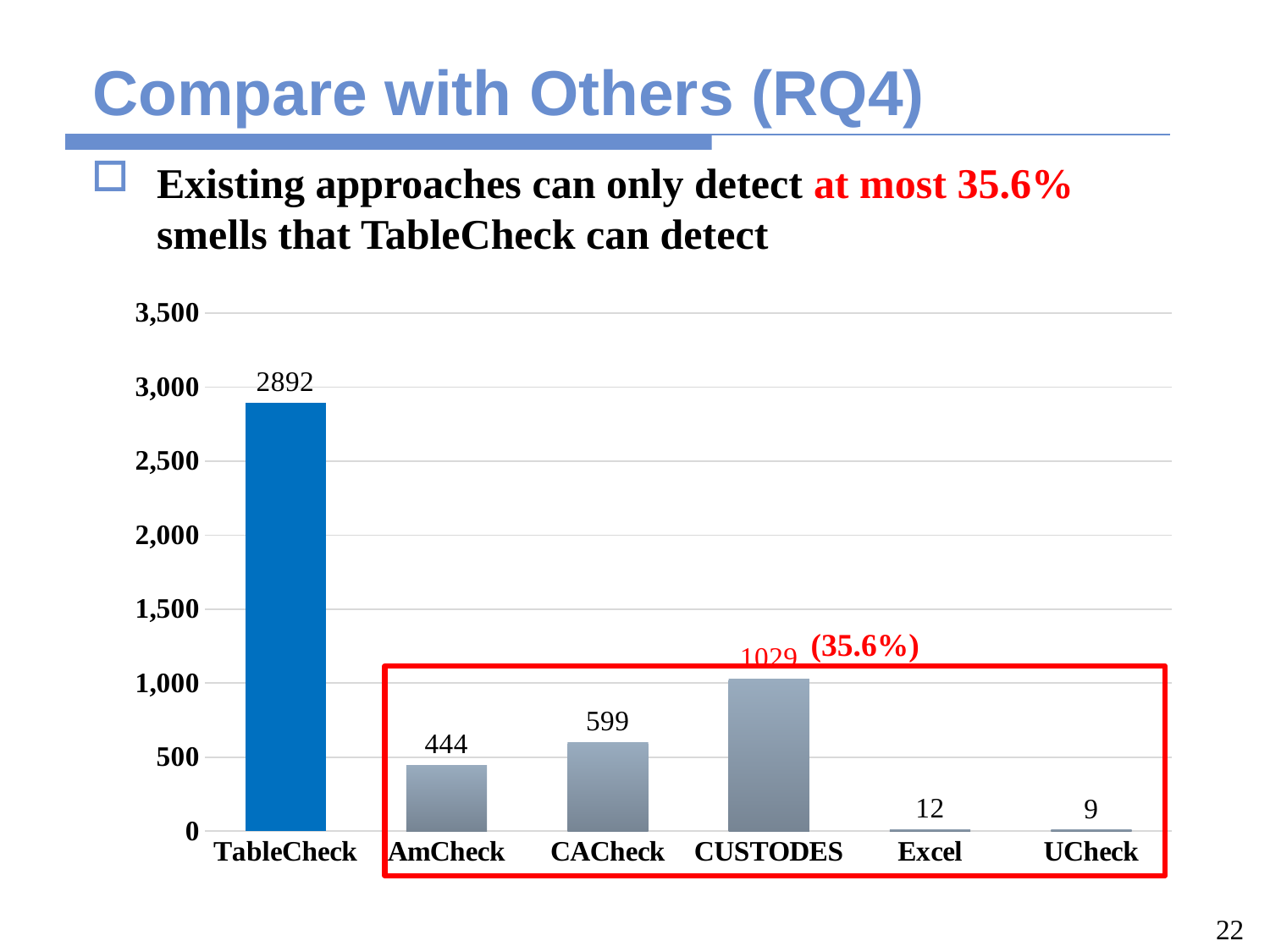
How many categories are shown on the x axis? 6 Which category has the highest value? TableCheck What is the value for UCheck? 9 Which category has the lowest value? UCheck Is the value for CUSTODES greater or less than 1,000? greater What is the difference between the values for TableCheck and CUSTODES? 1863 Which is larger, the value for CACheck or the value for AmCheck? CACheck What is the value for CUSTODES? 1029 What is the value for TableCheck? 2892 What is the difference between the values for CACheck and AmCheck? 155 What kind of chart is shown on the slide? bar chart What is the value for AmCheck? 444